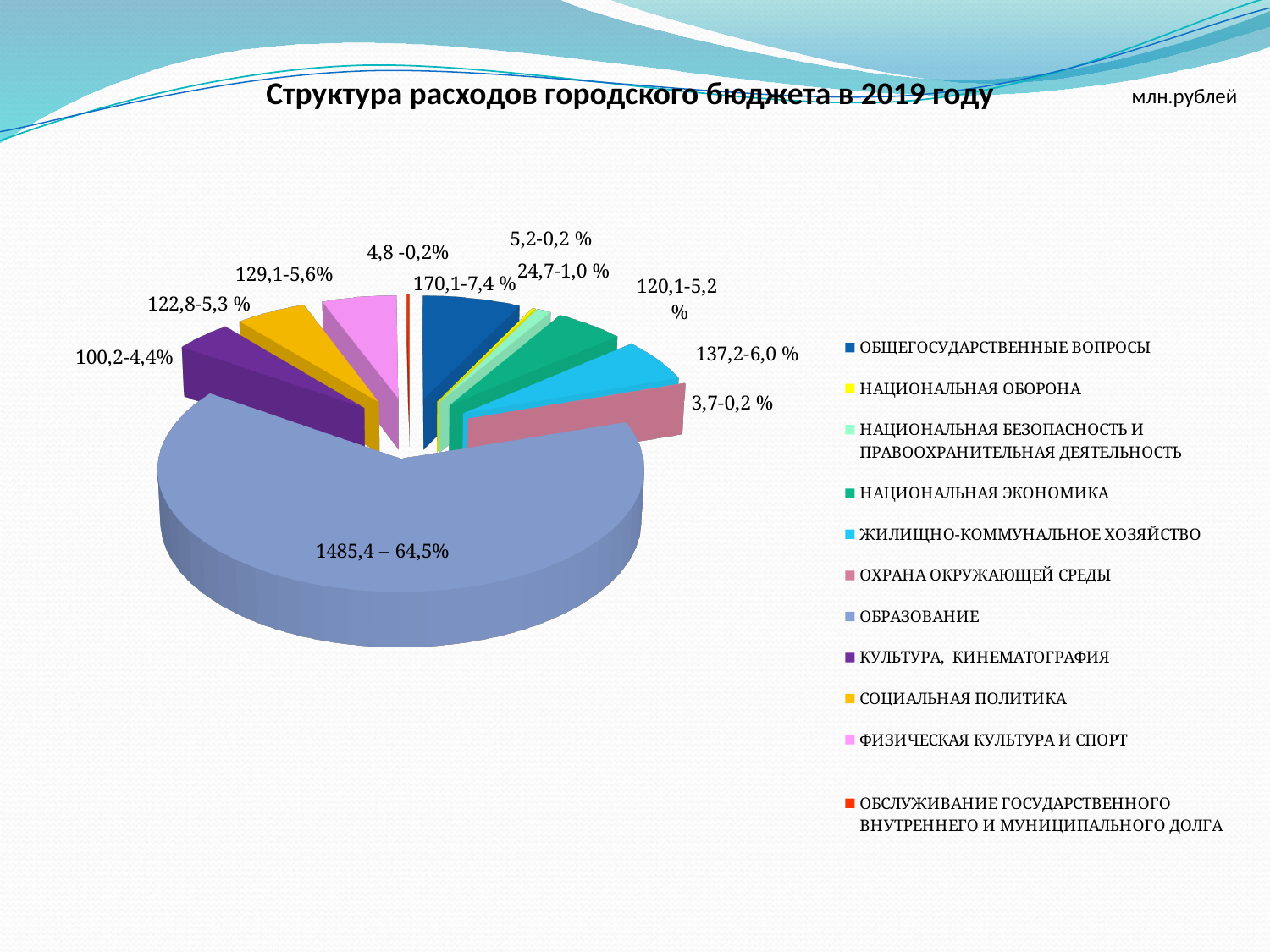
What share of the pie does ОБЩЕГОСУДАРСТВЕННЫЕ ВОПРОСЫ take? 7,4 % Which is larger, the value for ОБРАЗОВАНИЕ or the value for ОБЩЕГОСУДАРСТВЕННЫЕ ВОПРОСЫ? ОБРАЗОВАНИЕ What value is printed for ОБЩЕГОСУДАРСТВЕННЫЕ ВОПРОСЫ? 170,1 What is the smallest value printed on the chart? 3,7 What is the difference between the value for ОБРАЗОВАНИЕ and the value for ОБЩЕГОСУДАРСТВЕННЫЕ ВОПРОСЫ? 1315,3 Which category has the largest slice of the pie? ОБРАЗОВАНИЕ What is the title of the chart? Структура расходов городского бюджета в 2019 году What share of the pie does ОБРАЗОВАНИЕ take? 64,5% How many categories does the legend list? 11 What kind of chart is shown on the slide? pie chart In what units are the values on the chart given? млн.рублей What value is printed for ОБРАЗОВАНИЕ? 1485,4